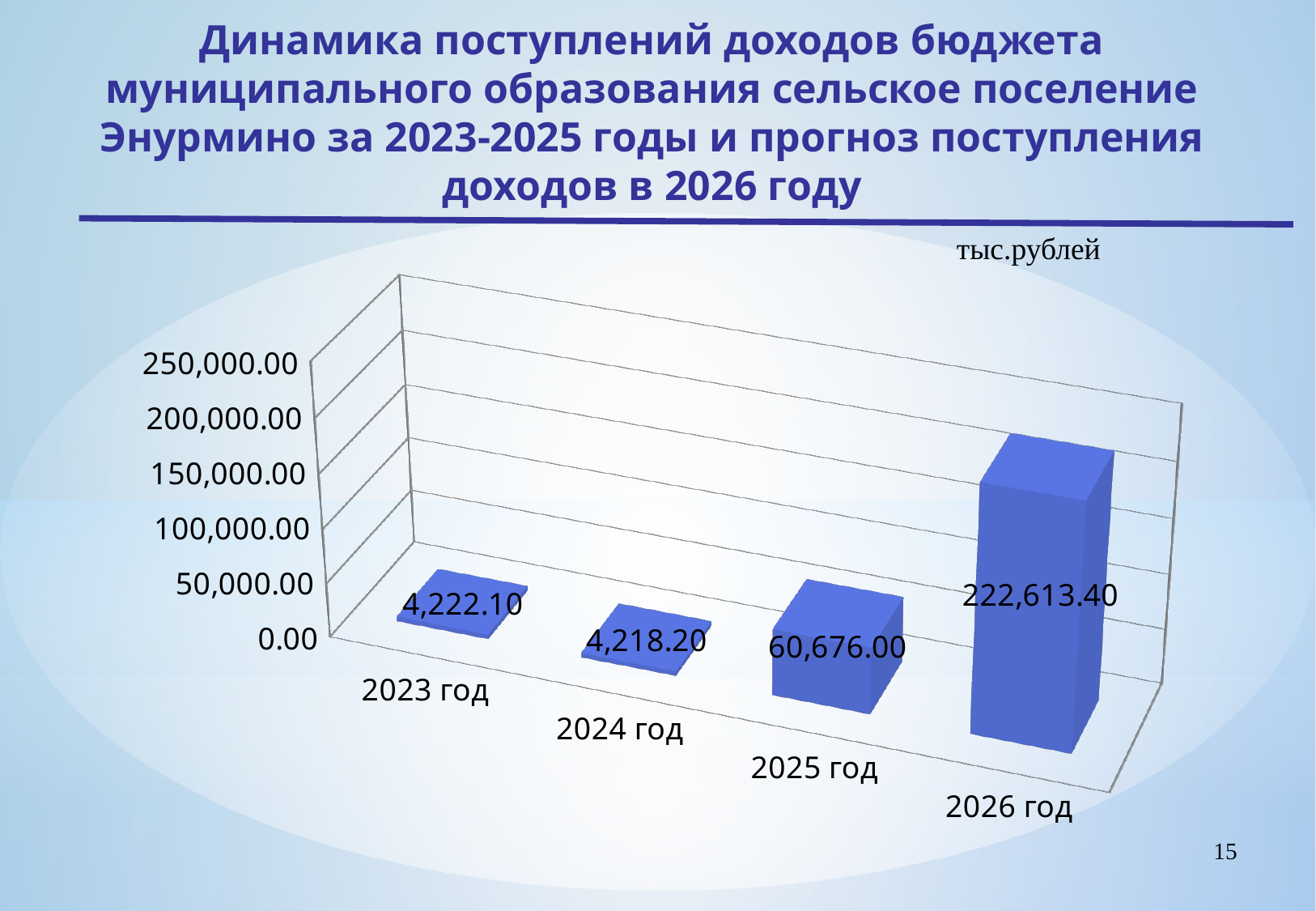
What is the value for 2025 год? 60,676.00 Which is larger, the value for 2025 год or the value for 2024 год? 2025 год What is the difference between the values for 2026 год and 2025 год? 161,937.40 Which year has the highest value? 2026 год What kind of chart is shown on the slide? bar chart Is the value for 2026 год greater or less than 200,000.00? greater How many years are shown on the chart? 4 What is the value for 2026 год? 222,613.40 What is the value for 2024 год? 4,218.20 Which year has the lowest value? 2024 год In what units are the values on the chart given, according to the label above the chart? тыс.рублей What is the value for 2023 год? 4,222.10